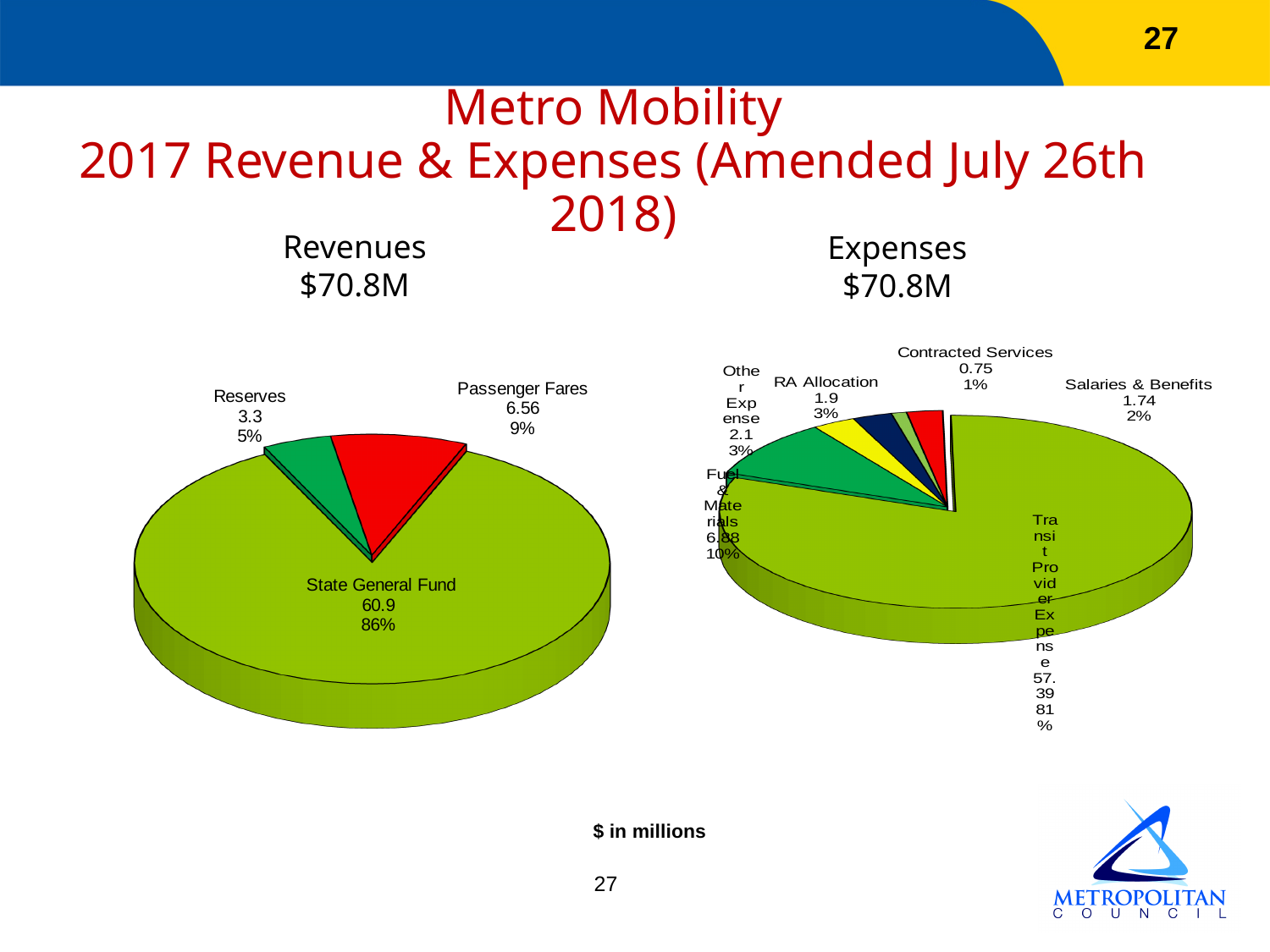
In the Expenses chart, which is larger, Salaries & Benefits or Contracted Services? Salaries & Benefits In the Revenues chart, which category is the largest? State General Fund In the Revenues chart, what is the value for State General Fund? 60.9 What type of chart is the Revenues chart? Pie chart How many categories are shown in the Revenues chart? 3 In the Revenues chart, which category is the smallest? Reserves How many categories are shown in the Expenses chart? 6 In the Revenues chart, what share of the pie is Passenger Fares? 9% In the Revenues chart, what is the value for Reserves? 3.3 In the Expenses chart, what share of the pie is Transit Provider Expense? 81% In the Revenues chart, what is the difference between Passenger Fares and Reserves? 3.26 In the Expenses chart, what is the value for RA Allocation? 1.9